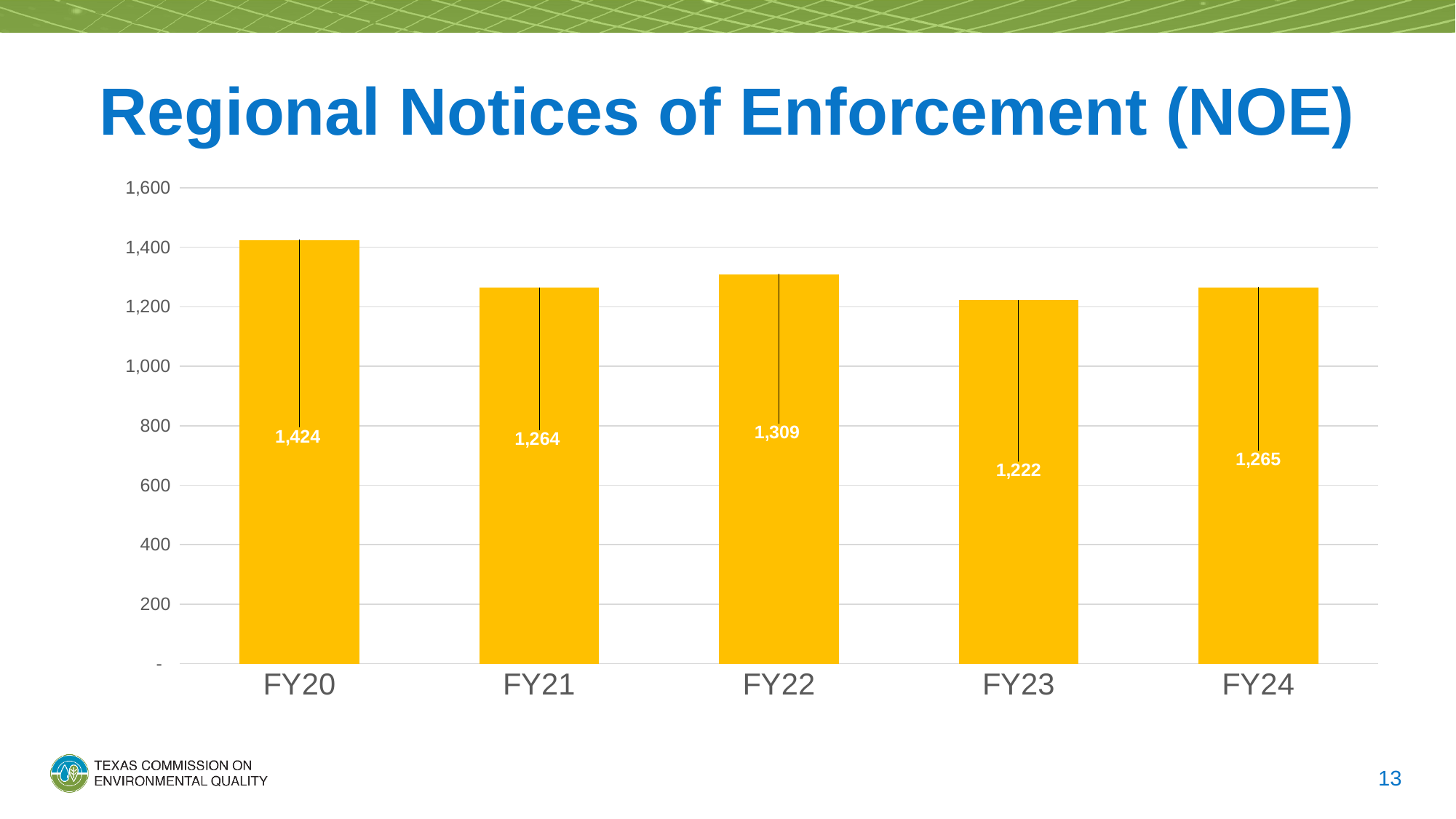
Which is larger, the value for FY22 or the value for FY24? FY22 Which fiscal year has the lowest value? FY23 What is the difference between the FY22 and FY23 values? 87 How many fiscal years are shown on the chart? 5 Is the value for FY23 greater or less than 1,400? less What kind of chart is shown on the slide? bar chart What is the value for FY22? 1,309 What is the title of the slide? Regional Notices of Enforcement (NOE) What is the value for FY23? 1,222 What is the difference between the FY20 and FY21 values? 160 What is the value for FY20? 1,424 Which fiscal year has the highest value? FY20